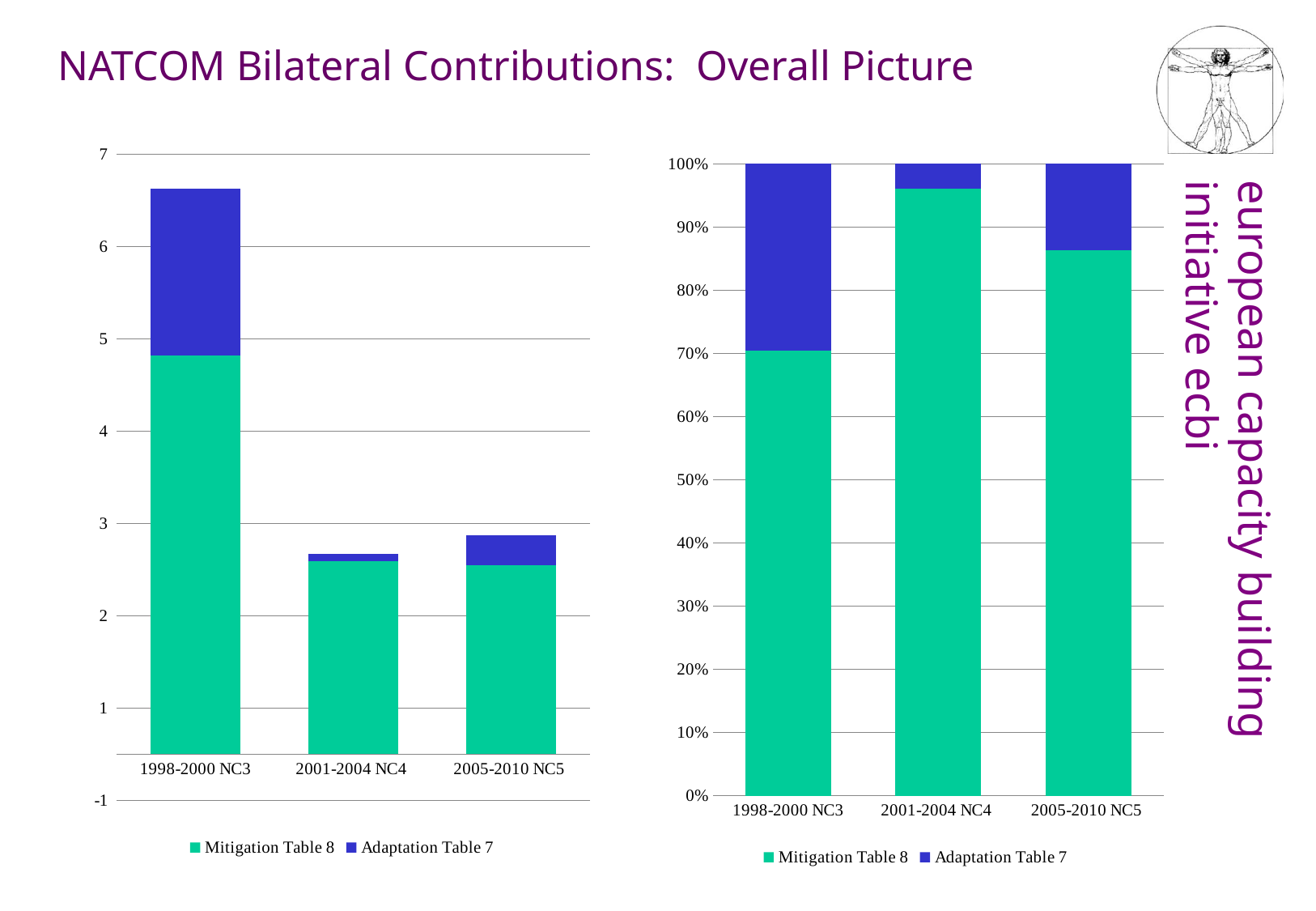
In the left chart, which period has the smallest Adaptation Table 7 segment? 2001-2004 NC4 In the right chart, is the Mitigation Table 8 share for 2001-2004 NC4 greater or less than 90%? greater In the left chart, which period has the tallest stacked bar overall? 1998-2000 NC3 In the left chart, is the total stacked bar for 2001-2004 NC4 greater or less than 3? less What kind of chart is the chart on the left of the slide? bar chart What is the title of the slide? NATCOM Bilateral Contributions: Overall Picture In the right chart, which period has the largest Adaptation Table 7 share? 1998-2000 NC3 How many series does the legend of the left chart list? 2 In the right chart, is the Adaptation Table 7 share larger for 2005-2010 NC5 or for 2001-2004 NC4? 2005-2010 NC5 How many periods are shown on the x axis of the left chart? 3 In the left chart, is the Mitigation Table 8 value for 1998-2000 NC3 greater or less than 4? greater